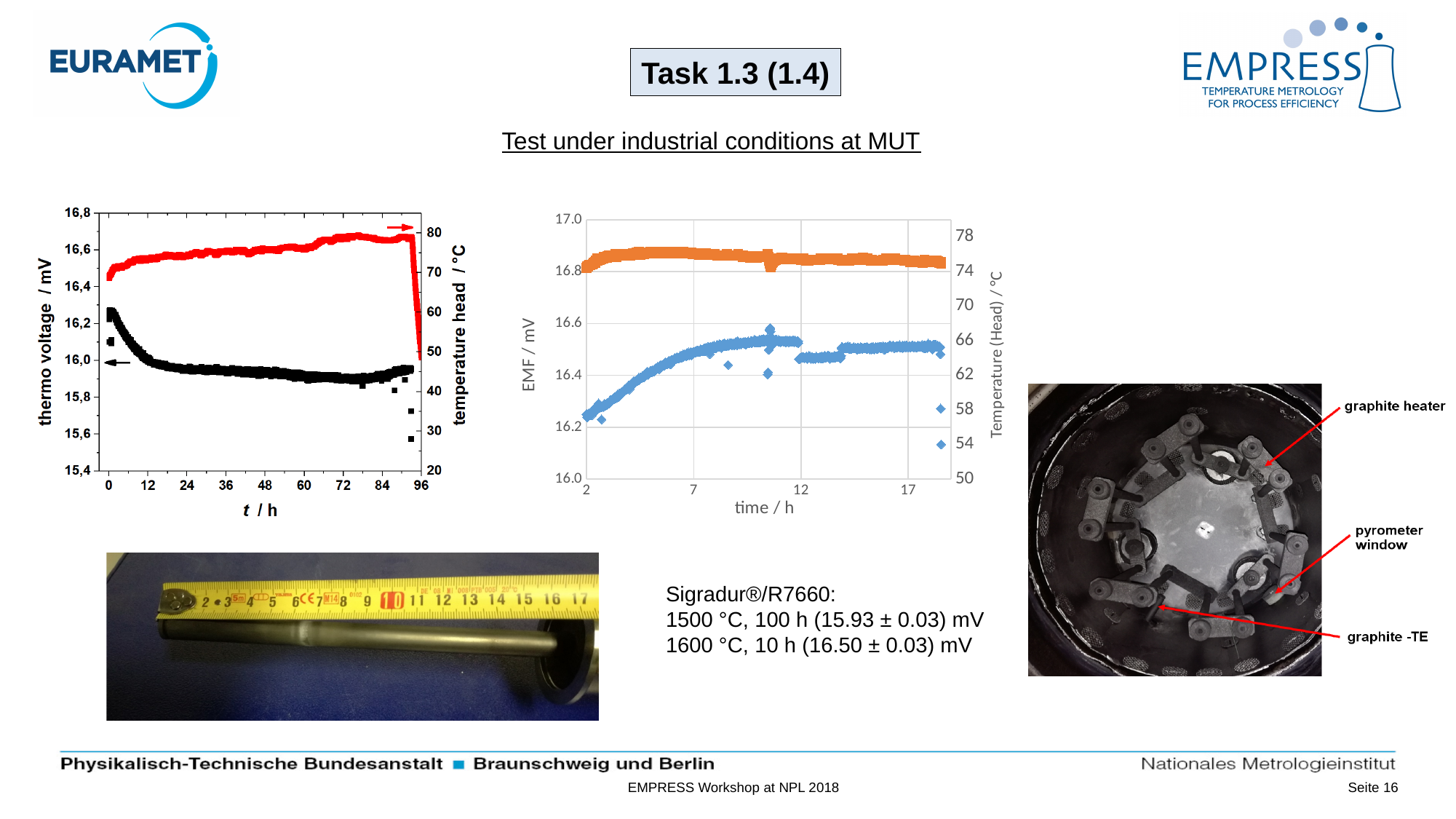
In the middle chart, what is the label of the right-hand y axis? Temperature (Head) / °C In the middle chart, is the EMF of the blue series at time = 2 h greater or less than 16.4 mV? less What kind of chart is the middle chart with the blue and orange series? scatter chart In the left chart, is the thermo voltage at t = 48 h greater or less than 16.0 mV? less In the middle chart, does the blue series rise or fall between time = 2 h and time = 7 h? rise In the middle chart, is the EMF of the blue series at time = 17 h greater or less than 16.4 mV? greater How many data series are plotted in the middle chart? 2 What kind of chart is the left chart with the black and red series? line chart In the left chart, what is the label of the x axis? t / h In the left chart, does the black thermo voltage series rise or fall between t = 0 h and t = 48 h? fall